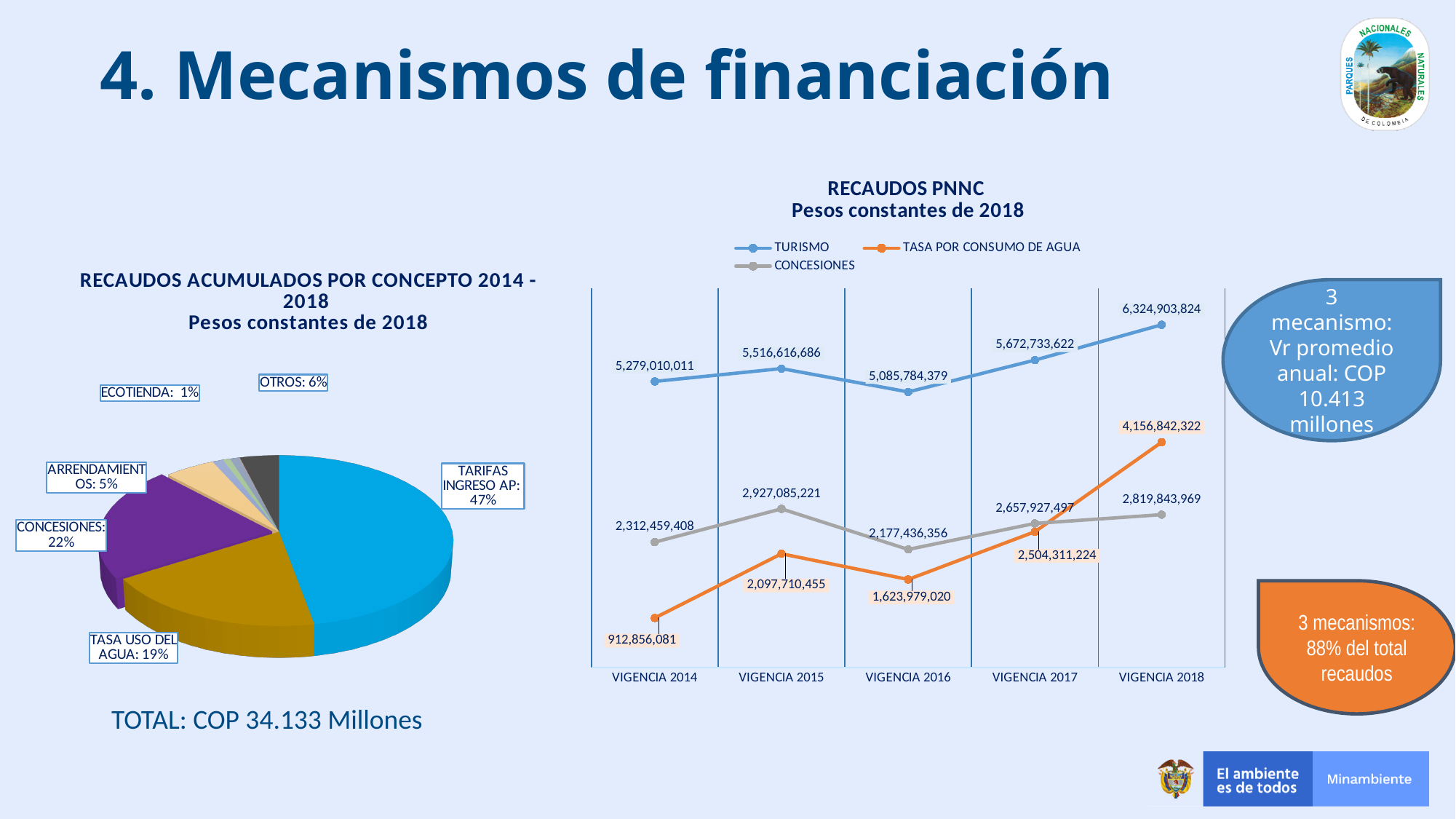
In the RECAUDOS PNNC chart, in VIGENCIA 2018, which is larger: TASA POR CONSUMO DE AGUA or CONCESIONES? TASA POR CONSUMO DE AGUA In the RECAUDOS PNNC chart, what is the CONCESIONES value for VIGENCIA 2016? 2,177,436,356 What kind of chart is the RECAUDOS ACUMULADOS POR CONCEPTO 2014 - 2018 chart? Pie chart In the RECAUDOS PNNC chart, which series has the highest value in VIGENCIA 2017? TURISMO In the RECAUDOS PNNC chart, what is the TURISMO value for VIGENCIA 2018? 6,324,903,824 In the RECAUDOS ACUMULADOS POR CONCEPTO 2014 - 2018 chart, what share does TARIFAS INGRESO AP have? 47% What kind of chart is the RECAUDOS PNNC chart? Line chart In the RECAUDOS ACUMULADOS POR CONCEPTO 2014 - 2018 chart, which category has the smallest share? ECOTIENDA In the RECAUDOS PNNC chart, what is the TASA POR CONSUMO DE AGUA value for VIGENCIA 2014? 912,856,081 In the RECAUDOS PNNC chart, how many series does the legend list? 3 In the RECAUDOS ACUMULADOS POR CONCEPTO 2014 - 2018 chart, what share does CONCESIONES have? 22% In the RECAUDOS ACUMULADOS POR CONCEPTO 2014 - 2018 chart, how many categories are labelled? 6